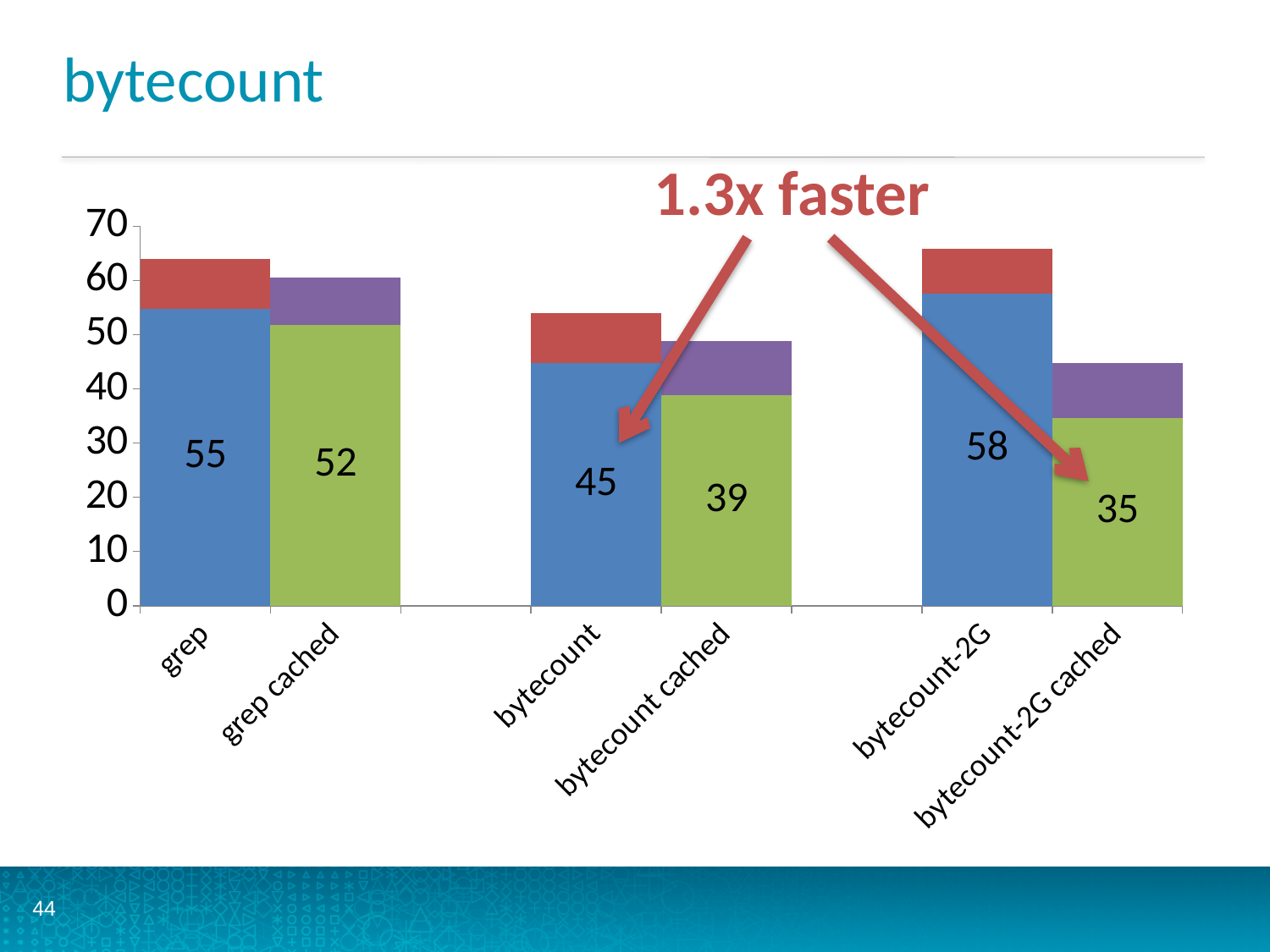
What is the labelled value on the bar for grep? 55 Which category has the lowest labelled value? bytecount-2G cached What is the difference between the labelled values for bytecount and bytecount cached? 6 How many categories are shown on the x axis? 6 Which category has the highest labelled value? bytecount-2G Which has the larger labelled value, grep or grep cached? grep What is the labelled value on the bar for bytecount cached? 39 What is the labelled value on the bar for bytecount-2G? 58 Is the total height of the grep bar greater or less than 60? greater What is the labelled value on the bar for bytecount-2G cached? 35 What kind of chart is shown on the slide? Stacked bar chart Is the total height of the bytecount-2G cached bar greater or less than 50? less